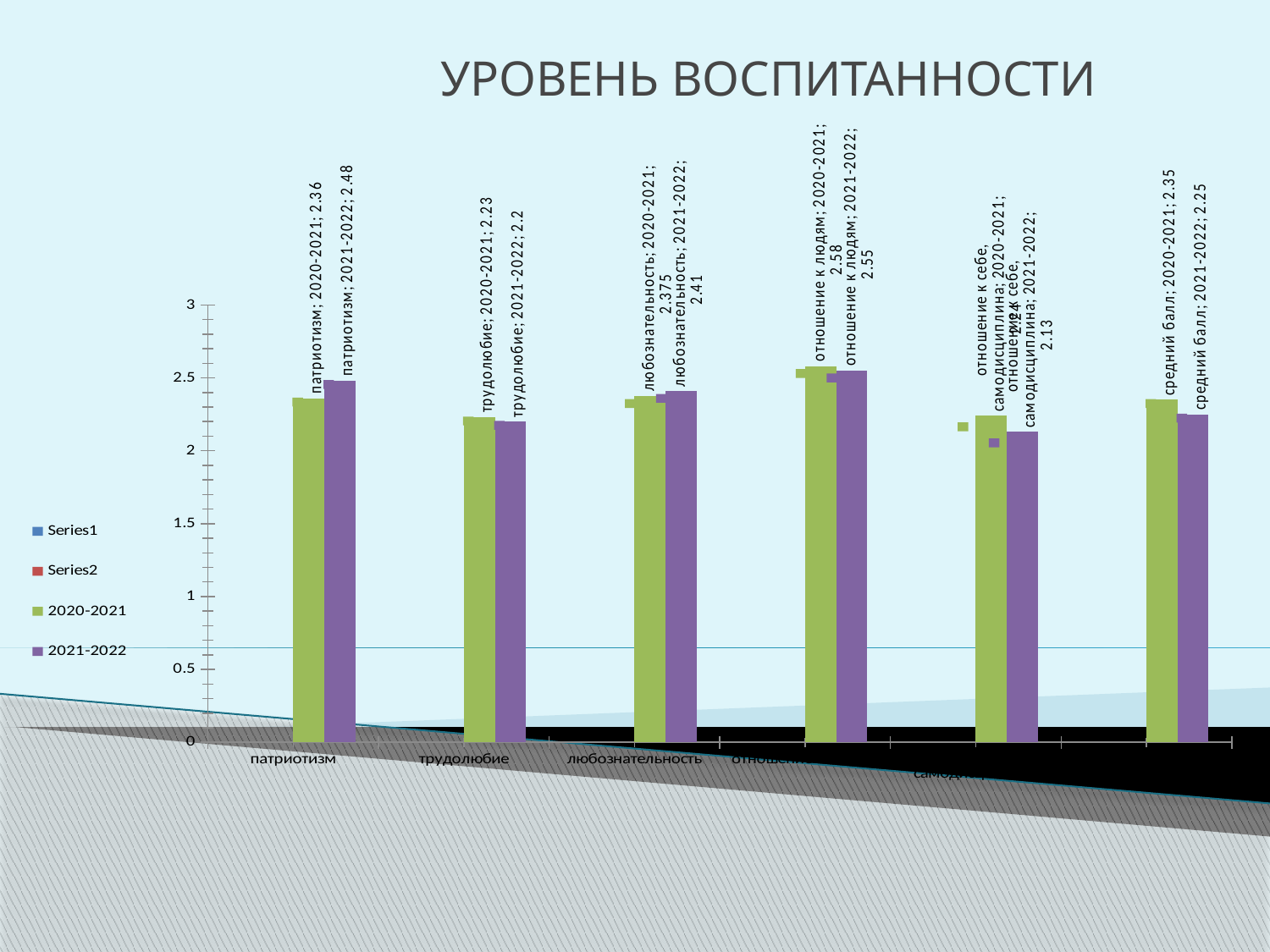
Which is larger for средний балл: the 2020-2021 value or the 2021-2022 value? 2020-2021 Which category has the highest value in the 2020-2021 series? отношение к людям What is the value for патриотизм in 2020-2021? 2.36 How many entries does the legend list? 4 What is the difference between the 2021-2022 and 2020-2021 values for патриотизм? 0.12 What is the value for патриотизм in 2021-2022? 2.48 What is the value for трудолюбие in 2021-2022? 2.2 What is the value for любознательность in 2020-2021? 2.375 What is the value for отношение к людям in 2020-2021? 2.58 What is the value for средний балл in 2021-2022? 2.25 What is the title of the chart? УРОВЕНЬ ВОСПИТАННОСТИ What kind of chart is shown on the slide? bar chart